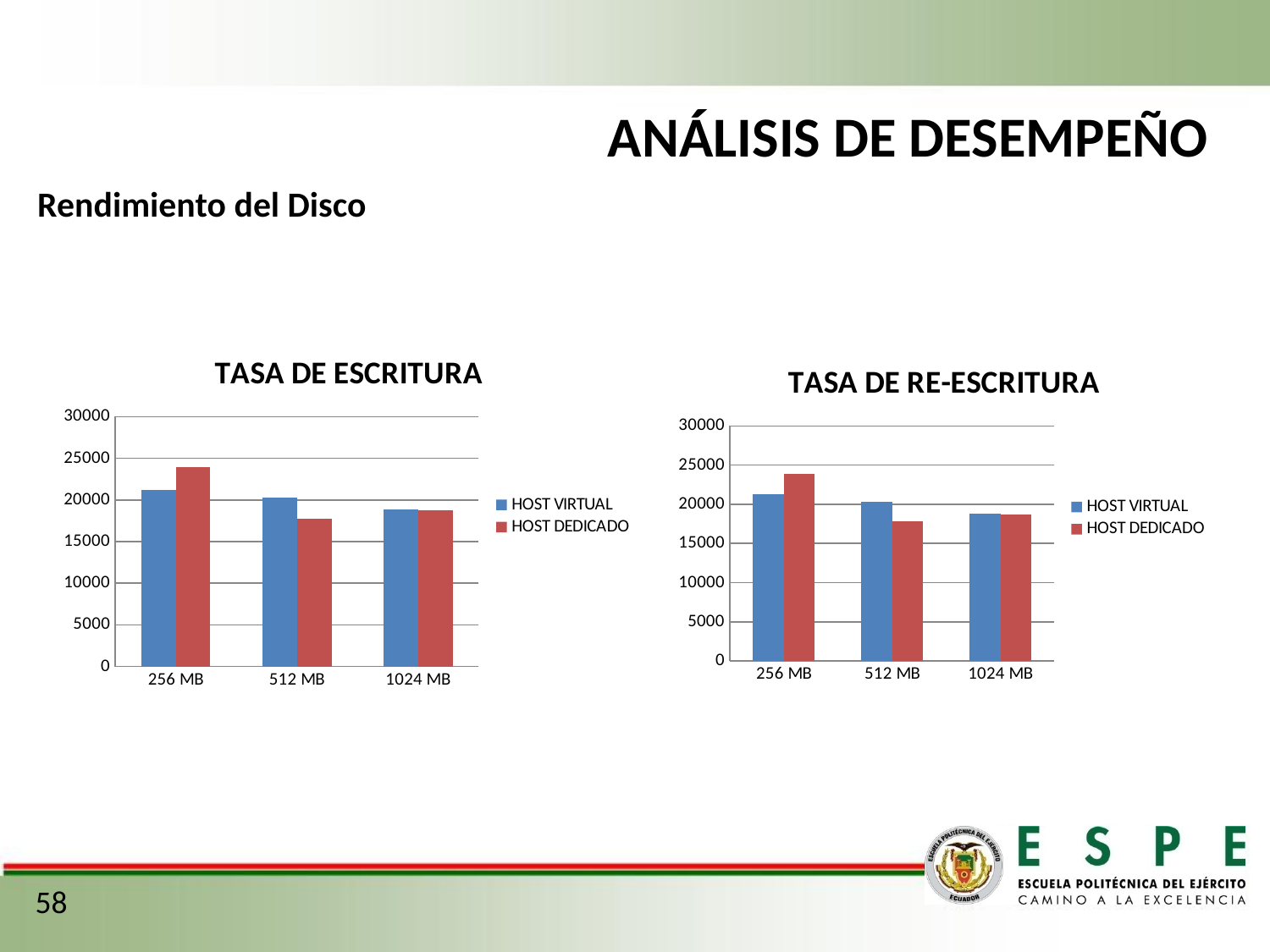
In the TASA DE RE-ESCRITURA chart, at which category is the HOST DEDICADO value lowest? 512 MB What is the title of the chart on the right side of the slide? TASA DE RE-ESCRITURA In the TASA DE RE-ESCRITURA chart, which is larger at 512 MB, HOST VIRTUAL or HOST DEDICADO? HOST VIRTUAL In the TASA DE ESCRITURA chart, is the HOST DEDICADO value for 512 MB greater or less than 20000? less In the TASA DE ESCRITURA chart, at which category is the HOST DEDICADO value highest? 256 MB In the TASA DE ESCRITURA chart, which is larger at 256 MB, HOST VIRTUAL or HOST DEDICADO? HOST DEDICADO In the TASA DE ESCRITURA chart, is the HOST DEDICADO value for 256 MB greater or less than 20000? greater What kind of chart is the TASA DE ESCRITURA chart? bar chart How many series does the legend of the TASA DE RE-ESCRITURA chart list? 2 In the TASA DE ESCRITURA chart, do the HOST VIRTUAL values rise or fall from 256 MB to 1024 MB? fall In the TASA DE RE-ESCRITURA chart, is the HOST VIRTUAL value for 1024 MB greater or less than 20000? less How many categories are shown on the x axis of the TASA DE ESCRITURA chart? 3